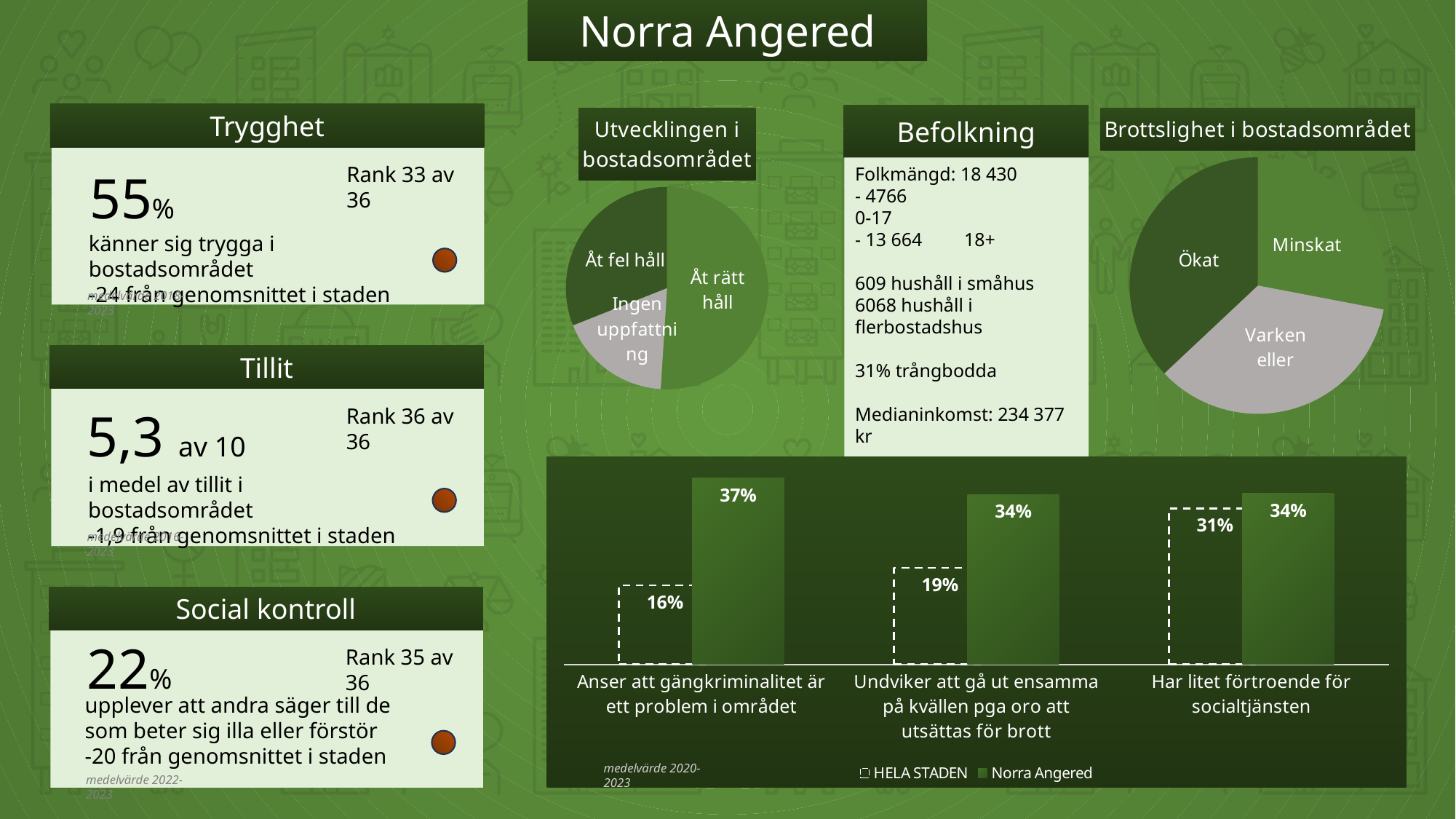
In the bar chart at the bottom, what is the value for HELA STADEN for 'Har litet förtroende för socialtjänsten'? 31% In the bar chart at the bottom, which category has the highest Norra Angered value? Anser att gängkriminalitet är ett problem i området In the bar chart at the bottom, what is the difference between Norra Angered and HELA STADEN for 'Har litet förtroende för socialtjänsten'? 3% What kind of chart is 'Utvecklingen i bostadsområdet'? Pie chart In the bar chart at the bottom, what is the value for Norra Angered for 'Anser att gängkriminalitet är ett problem i området'? 37% In the bar chart at the bottom, how many series does the legend list? 2 In the pie chart 'Utvecklingen i bostadsområdet', which slice is the largest? Åt rätt håll In the bar chart at the bottom, what is the value for HELA STADEN for 'Undviker att gå ut ensamma på kvällen pga oro att utsättas för brott'? 19% In the bar chart at the bottom, what is the difference between Norra Angered and HELA STADEN for 'Anser att gängkriminalitet är ett problem i området'? 21% In the bar chart at the bottom, which category has the lowest HELA STADEN value? Anser att gängkriminalitet är ett problem i området In the bar chart at the bottom, how many categories are shown? 3